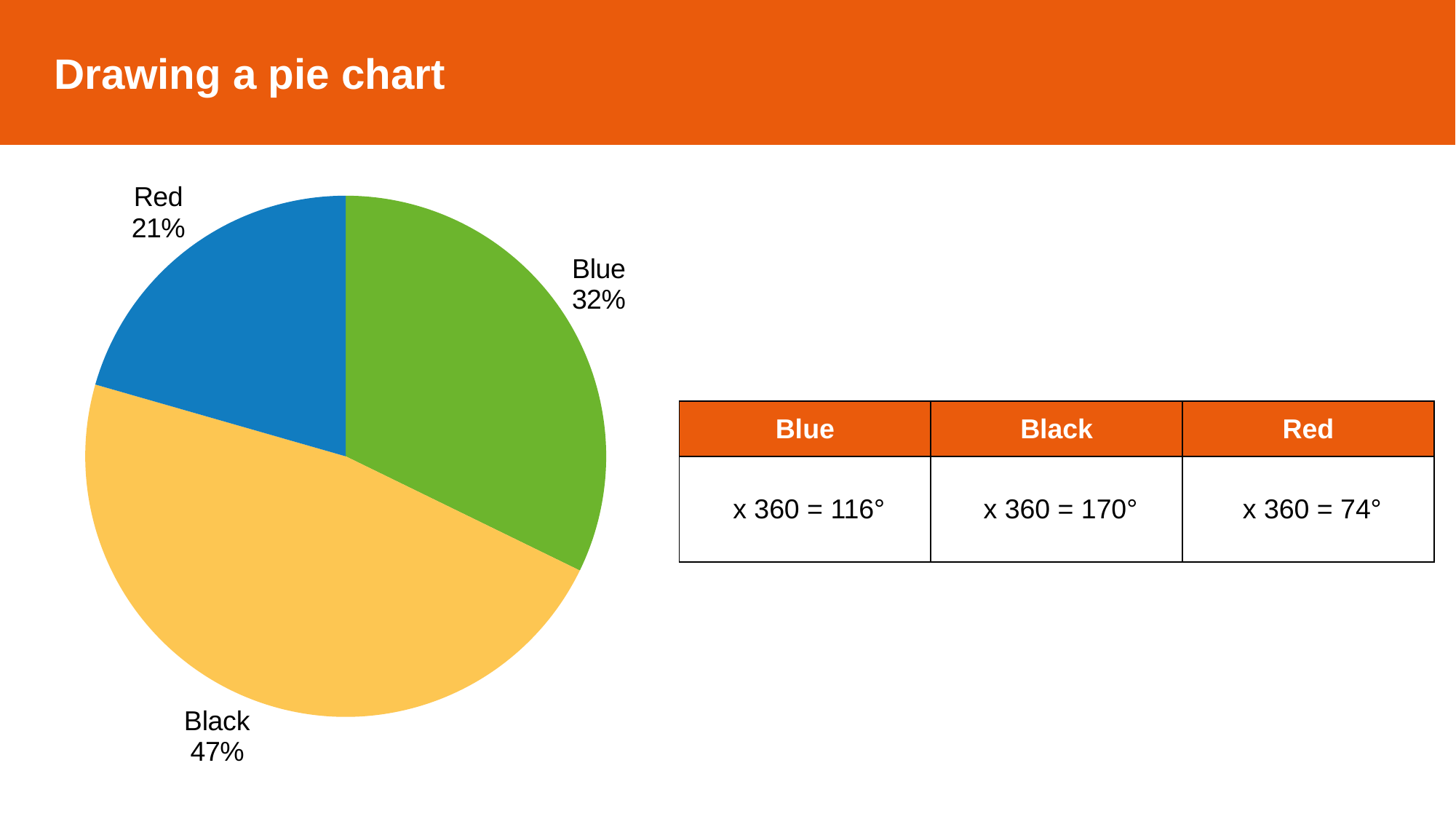
What colour is the Black slice drawn in on the pie chart? yellow What is the title of the slide containing the pie chart? Drawing a pie chart What percentage does the Blue slice represent? 32% What kind of chart is shown on the slide? pie chart What percentage does the Red slice represent? 21% What percentage does the Black slice represent? 47% Which slice of the pie chart is the largest? Black How many slices does the pie chart have? 3 What is the difference in percentage points between the Blue and Red slices? 11 Which slice of the pie chart is the smallest? Red What is the difference in percentage points between the Black and Blue slices? 15 Which slice is larger, Blue or Red? Blue